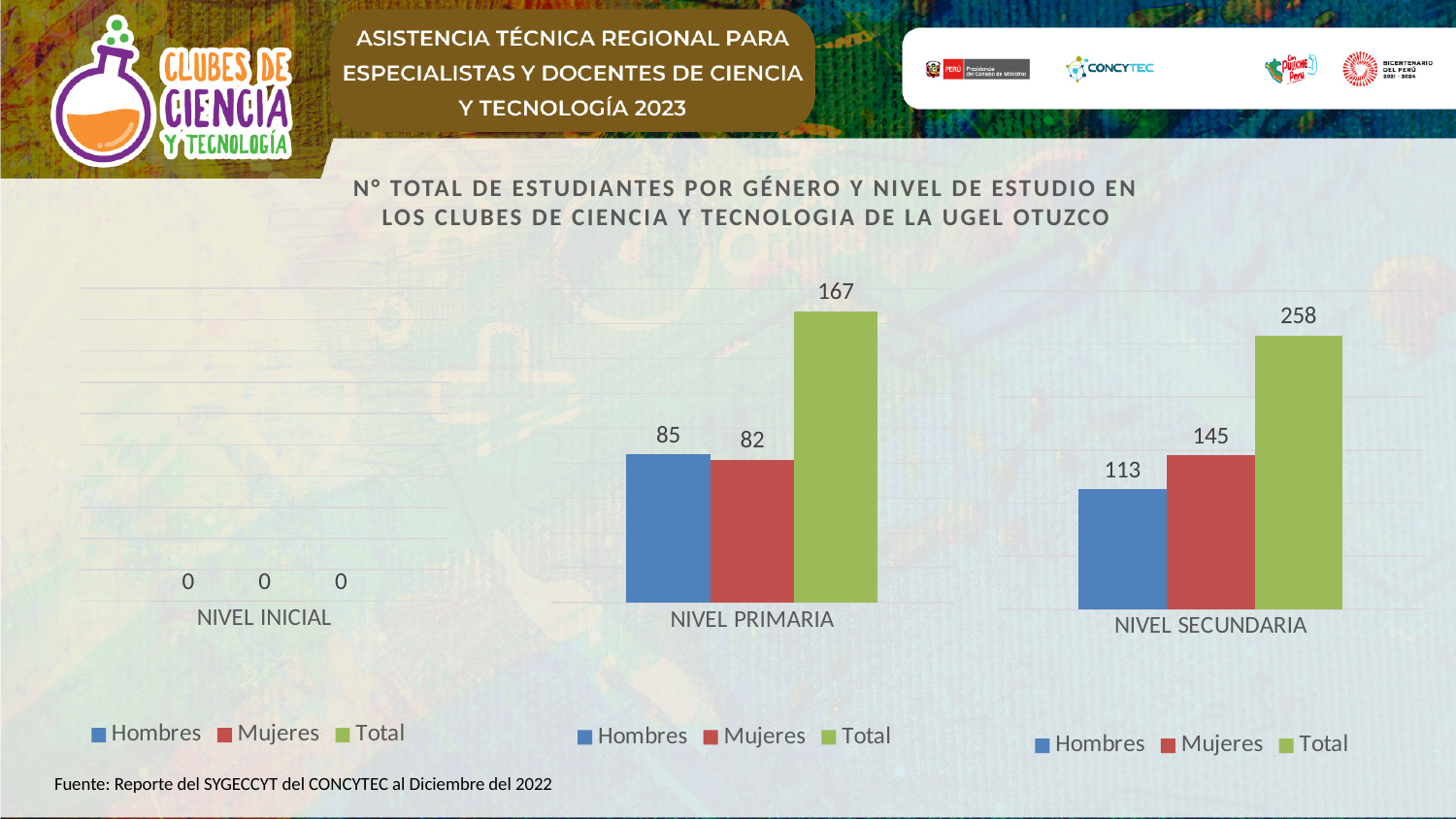
What kind of chart is the NIVEL SECUNDARIA chart? Bar chart In the NIVEL INICIAL chart, what is the value for Total? 0 In the NIVEL PRIMARIA chart, what is the difference between Total and Hombres? 82 In the NIVEL SECUNDARIA chart, which series has the lowest value? Hombres In the NIVEL SECUNDARIA chart, what is the value for Hombres? 113 In the NIVEL SECUNDARIA chart, what is the value for Total? 258 How many series does the legend of the NIVEL PRIMARIA chart list? 3 In the NIVEL SECUNDARIA chart, what is the difference between Mujeres and Hombres? 32 Which is larger: Mujeres in the NIVEL SECUNDARIA chart or Mujeres in the NIVEL PRIMARIA chart? NIVEL SECUNDARIA In the NIVEL PRIMARIA chart, what is the value for Mujeres? 82 In the NIVEL SECUNDARIA chart, which series has the highest value? Total In the NIVEL PRIMARIA chart, what is the value for Hombres? 85